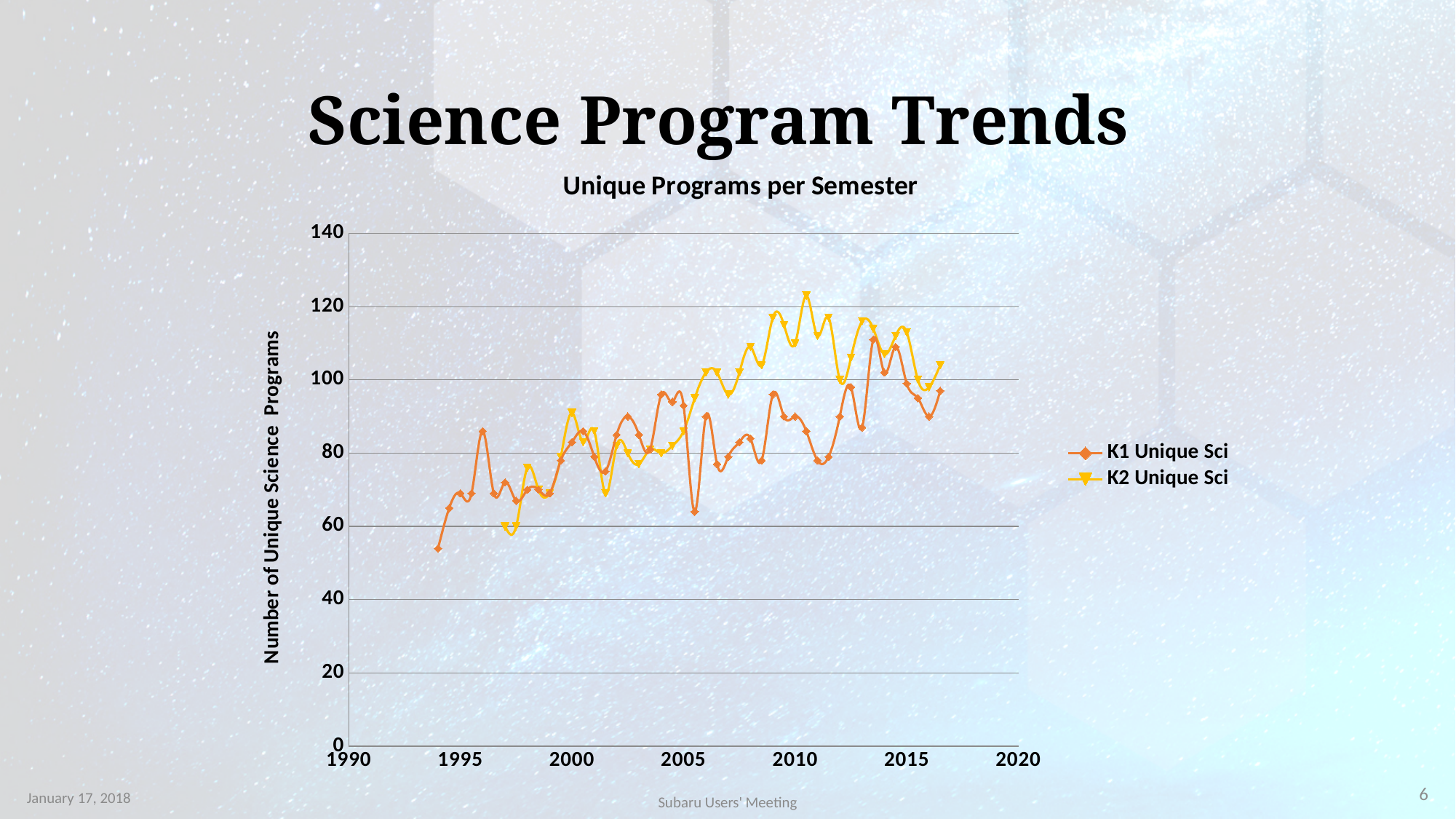
What kind of chart is shown on the slide? line chart Is the highest value of the K1 Unique Sci series greater or less than 100? greater Is the highest value of the K2 Unique Sci series greater or less than 120? greater Is the lowest value of the K1 Unique Sci series greater or less than 60? less What is the label of the vertical axis? Number of Unique Science Programs Which series starts earlier on the x axis, K1 Unique Sci or K2 Unique Sci? K1 Unique Sci Does the K1 Unique Sci series generally rise or fall between 1995 and 2015? rise Does the K2 Unique Sci series generally rise or fall between 1997 and 2010? rise How many series does the legend list? 2 Which series reaches the higher peak value, K1 Unique Sci or K2 Unique Sci? K2 Unique Sci What is the title of the chart? Unique Programs per Semester